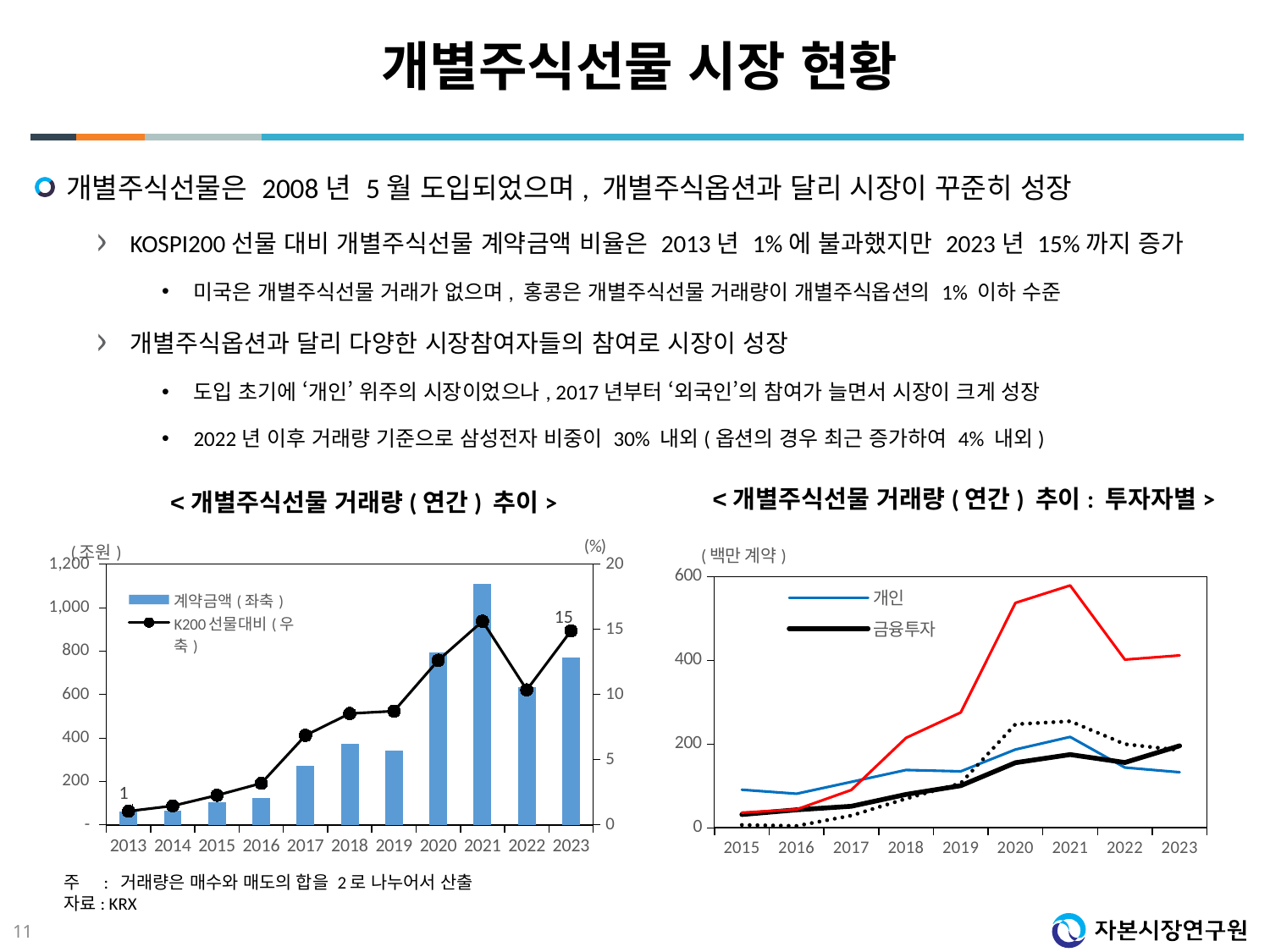
In the left chart (개별주식선물 거래량 (연간) 추이), what is the K200 선물대비 value for 2023? 15 In the right chart (개별주식선물 거래량 (연간) 추이 : 투자자별), how many years are shown on the x axis? 9 In the left chart (개별주식선물 거래량 (연간) 추이), which is larger, the 계약금액 bar for 2021 or for 2022? 2021 In the left chart (개별주식선물 거래량 (연간) 추이), how many years are shown on the x axis? 11 What kind of chart is the right chart (개별주식선물 거래량 (연간) 추이 : 투자자별)? line chart In the left chart (개별주식선물 거래량 (연간) 추이), what is the K200 선물대비 value for 2013? 1 In the left chart (개별주식선물 거래량 (연간) 추이), by how much did the K200 선물대비 value increase from 2013 to 2023? 14 In the left chart (개별주식선물 거래량 (연간) 추이), is the 계약금액 bar for 2021 greater or less than 1,000? greater In the right chart (개별주식선물 거래량 (연간) 추이 : 투자자별), which series is higher in 2016, 개인 or 금융투자? 개인 In the left chart (개별주식선물 거래량 (연간) 추이), which year has the lowest 계약금액 bar? 2013 In the left chart (개별주식선물 거래량 (연간) 추이), which year has the highest 계약금액 bar? 2021 In the left chart (개별주식선물 거래량 (연간) 추이), is the 계약금액 bar for 2018 greater or less than 400? less